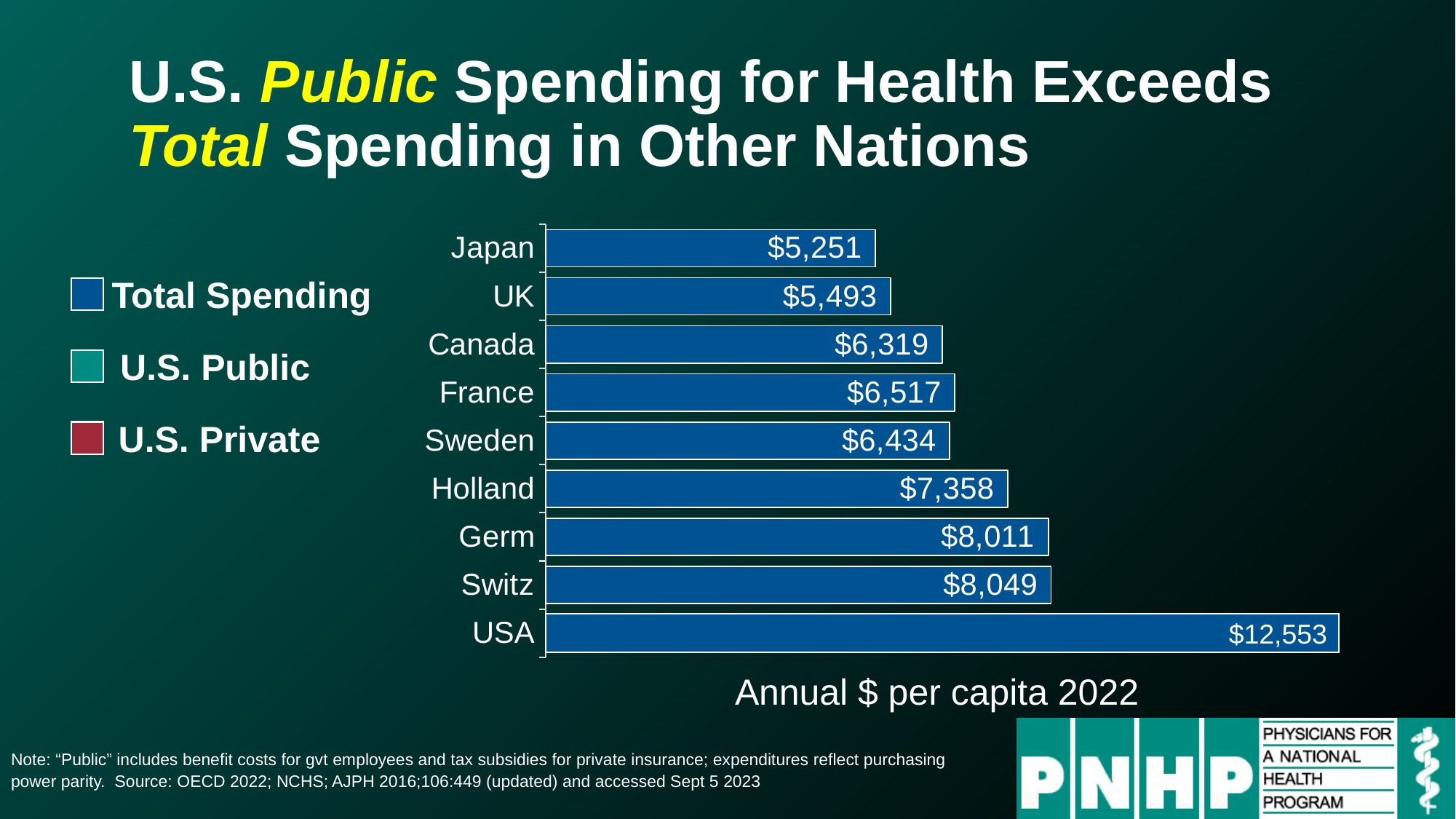
What is the value for Sweden? $6,434 What is the difference between the values for Canada and Japan? $1,068 What is the difference between the values for USA and Switz? $4,504 Which is larger, the value for Holland or the value for Canada? Holland What is the value for Holland? $7,358 What is the axis label shown below the chart? Annual $ per capita 2022 Which country has the lowest value? Japan What is the value for USA? $12,553 What kind of chart is shown on the slide? Bar chart How many countries are shown in the chart? 9 What is the value for Japan? $5,251 Which country has the highest value? USA